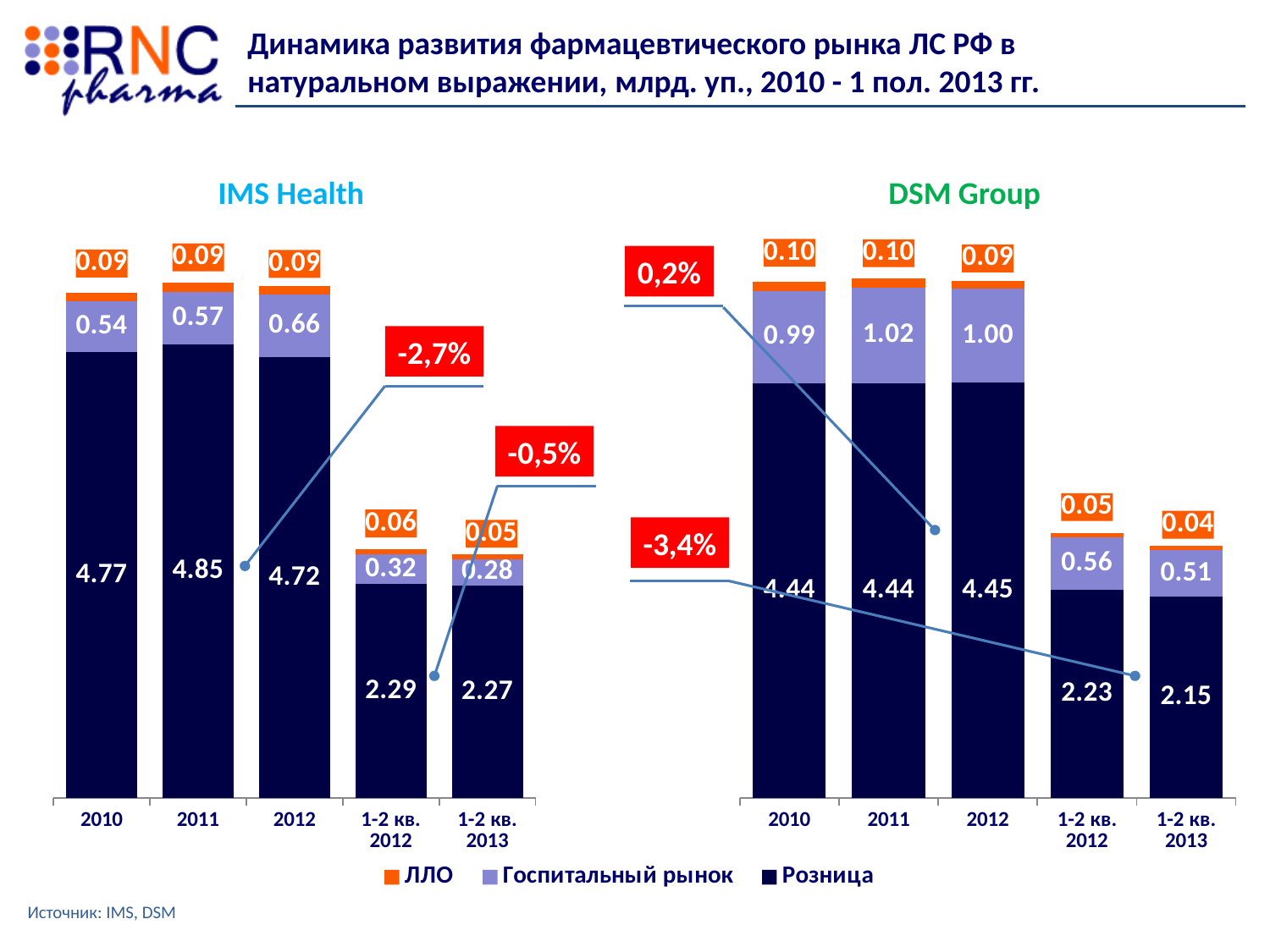
In the DSM Group chart, which is larger: Розница for 2012 or Розница for 2010? 2012 How many series does the legend list? 3 In the DSM Group chart, what is the total of the stacked bar for 2010? 5.53 In the DSM Group chart, what is the value of Розница for 1-2 кв. 2013? 2.15 In the DSM Group chart, what is the value of Госпитальный рынок for 2011? 1.02 In the IMS Health chart, what is the value of Розница for 2011? 4.85 In the IMS Health chart, what is the total of the stacked bar for 2011? 5.51 In the IMS Health chart, what is the difference between the Госпитальный рынок values for 2012 and 2010? 0.12 In the IMS Health chart, which year has the highest Розница value? 2011 In the IMS Health chart, what is the value of ЛЛО for 1-2 кв. 2013? 0.05 In the DSM Group chart, which category has the lowest ЛЛО value? 1-2 кв. 2013 What type of chart is the DSM Group chart? Stacked bar chart